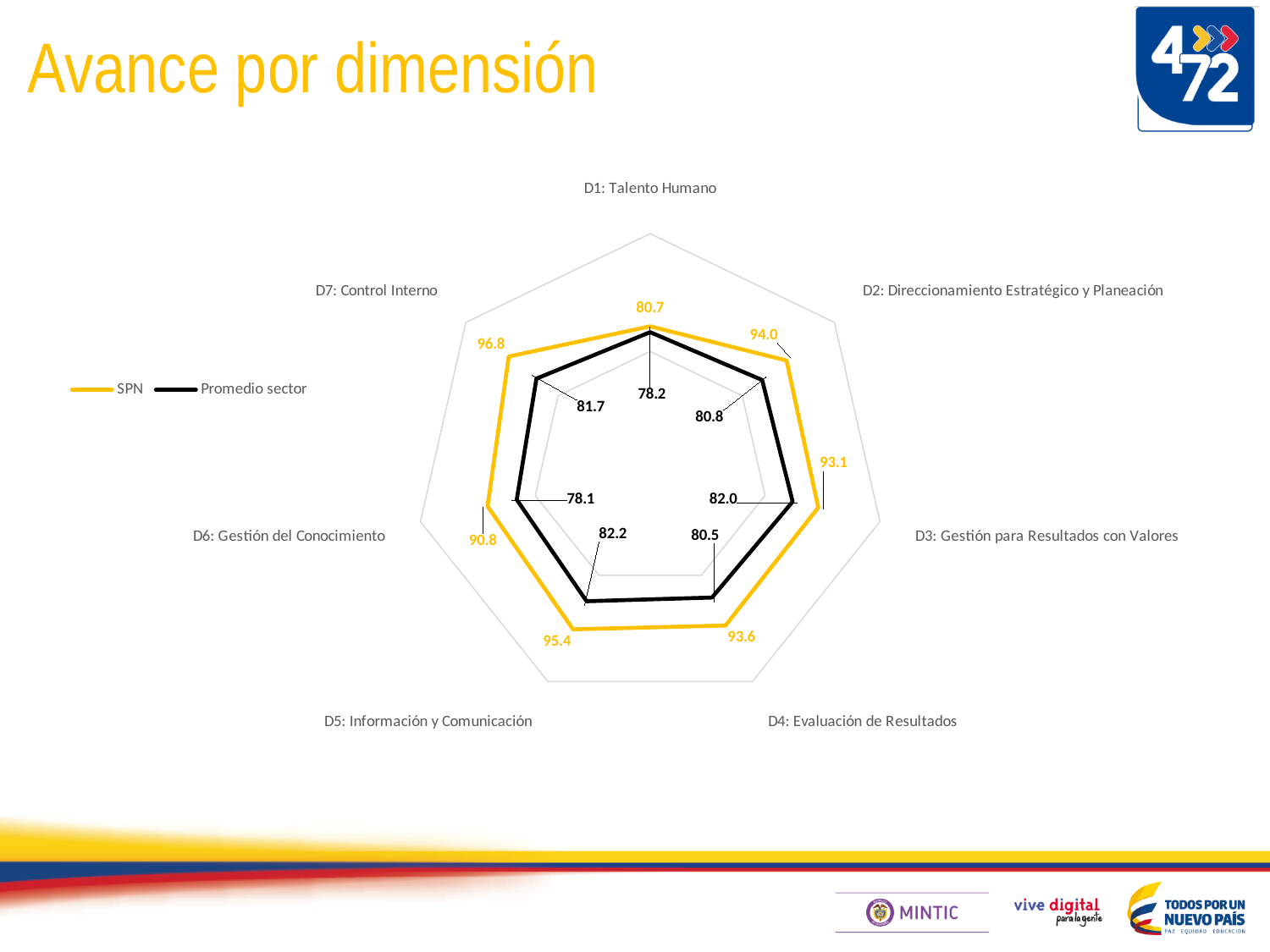
What is the difference between the SPN and Promedio sector values for D7: Control Interno? 15.1 What is the SPN value for D1: Talento Humano? 80.7 Which is larger for D2: Direccionamiento Estratégico y Planeación, the SPN value or the Promedio sector value? SPN Which dimension has the lowest Promedio sector value? D6: Gestión del Conocimiento How many dimensions are plotted on the chart? 7 What type of chart is shown on the slide? Radar chart How many series does the legend list? 2 Which dimension has the lowest SPN value? D1: Talento Humano What is the Promedio sector value for D6: Gestión del Conocimiento? 78.1 What is the Promedio sector value for D3: Gestión para Resultados con Valores? 82.0 Which dimension has the highest SPN value? D7: Control Interno What is the SPN value for D5: Información y Comunicación? 95.4